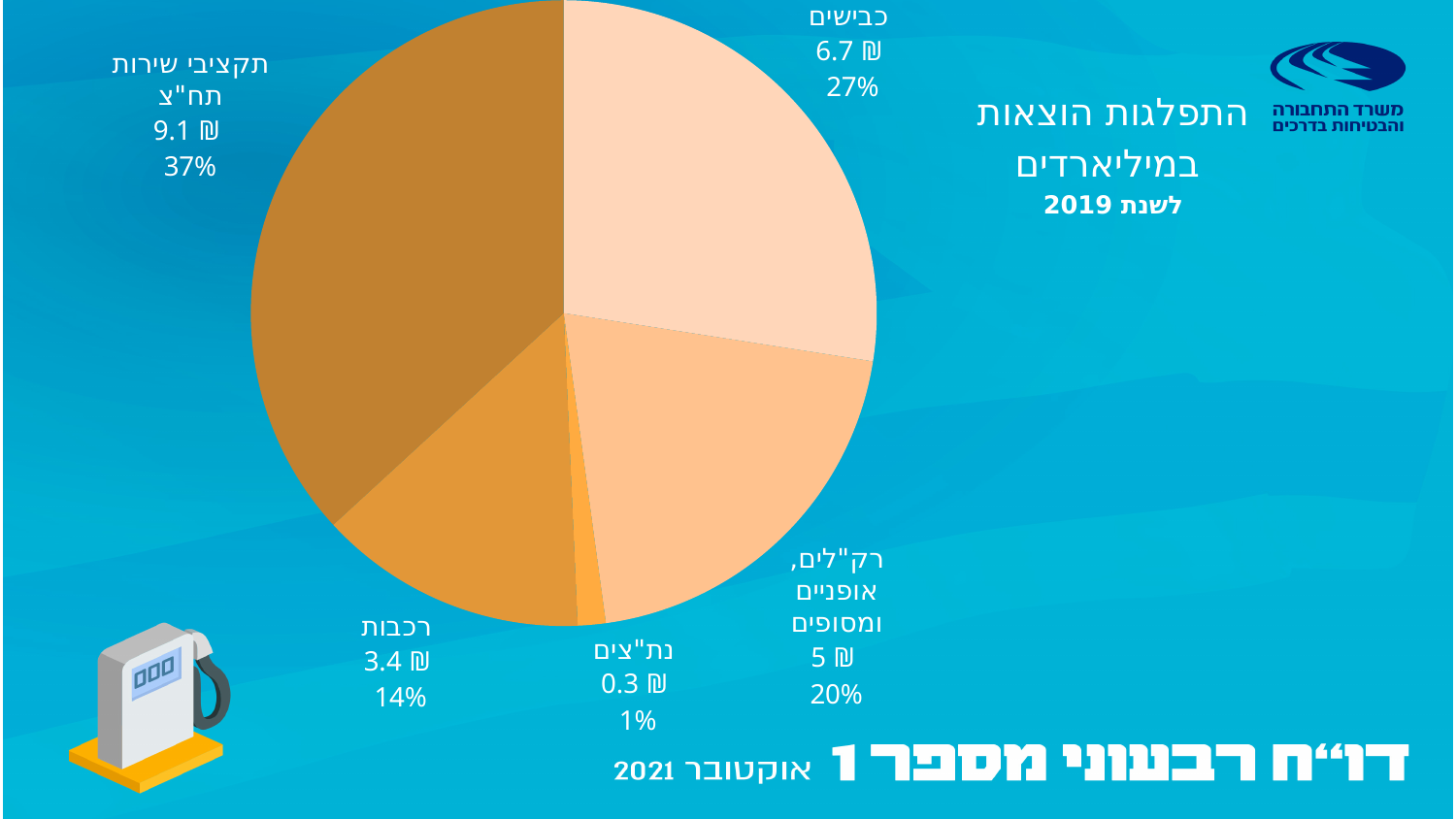
Which is larger: the value for רק"לים, אופניים ומסופים or the value for רכבות? רק"לים, אופניים ומסופים What is the value shown for כבישים (roads)? ₪ 6.7 Which category has the smallest slice of the pie? נת"צים How many slices does the pie chart have? 5 What percentage share does תקציבי שירות תח"צ have in the pie chart? 37% What is the difference in value between תקציבי שירות תח"צ and כבישים? ₪ 2.4 What is the value shown for רכבות (trains)? ₪ 3.4 What kind of chart is shown on the slide? pie chart What percentage share does נת"צים have in the pie chart? 1% Which category has the largest slice of the pie? תקציבי שירות תח"צ Which year does the chart title say the expense distribution is for? 2019 What percentage share does רק"לים, אופניים ומסופים have in the pie chart? 20%